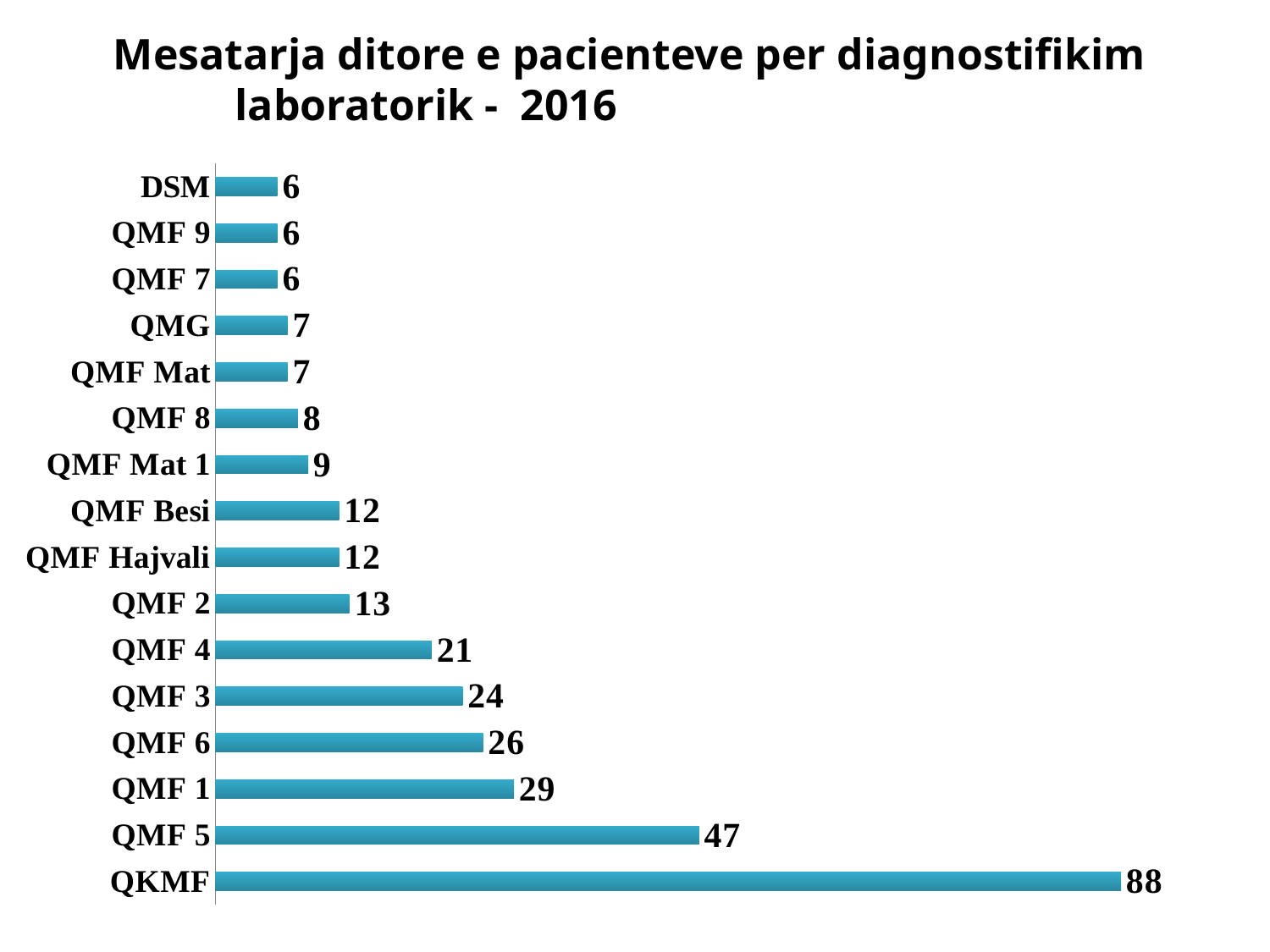
What is the difference between the values for QKMF and QMF 5? 41 What is the value for QMF Mat 1? 9 What is the difference between the values for QMF 1 and QMF 6? 3 What kind of chart is shown on the slide? Bar chart Which is larger, the value for QMF 2 or the value for QMF 8? QMF 2 Which is larger, the value for QMF 4 or the value for QMF 3? QMF 3 What is the value for QMF 5? 47 Which category has the highest value? QKMF What is the value for QMF Hajvali? 12 How many categories are shown in the chart? 16 What is the title of the chart? Mesatarja ditore e pacienteve per diagnostifikim laboratorik - 2016 What is the value for QKMF? 88